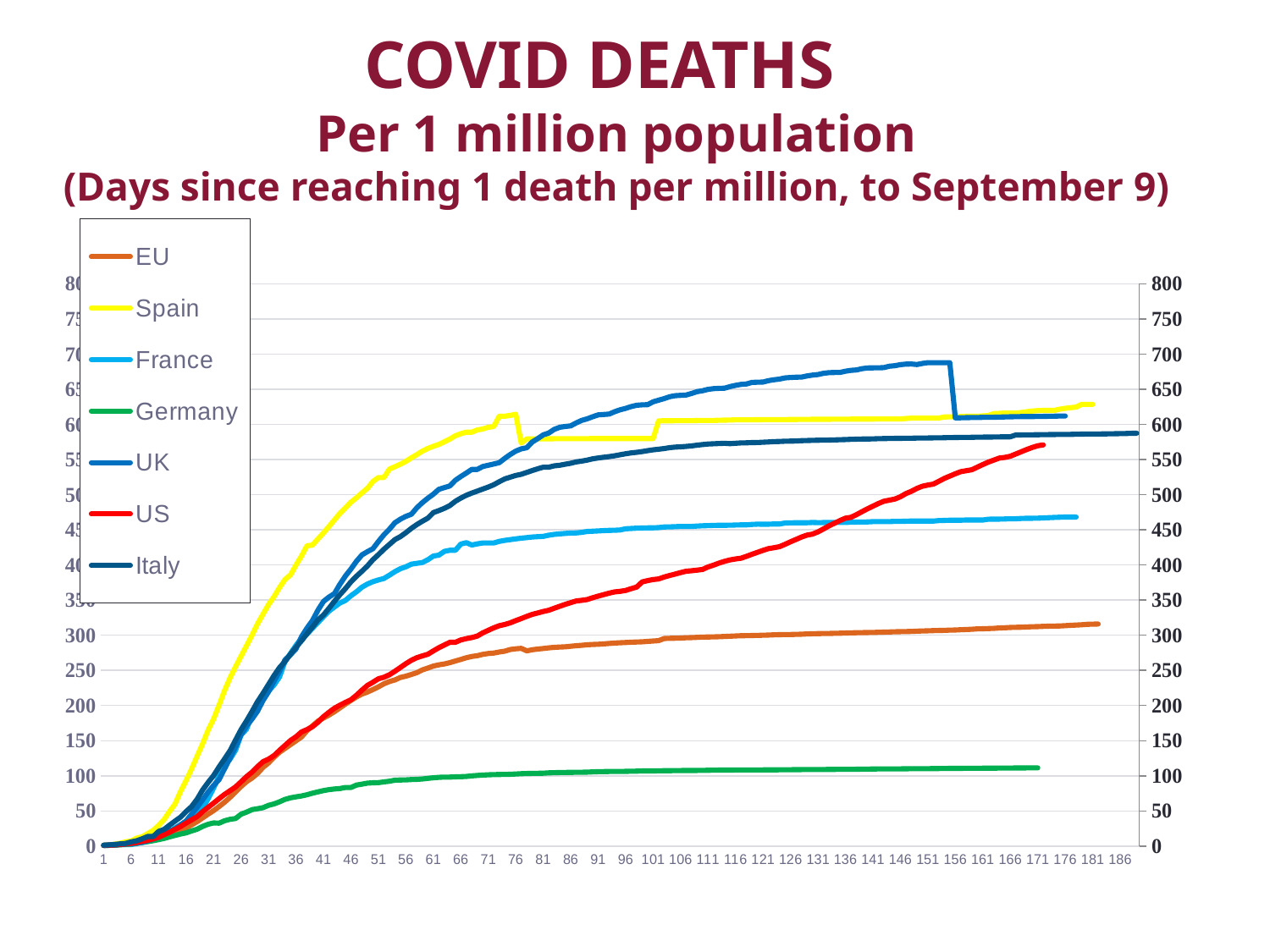
Is the final value for Germany greater or less than 150? less Is the final value for France greater or less than 500? less Which series reaches the highest value at any point on the chart? UK What kind of chart is shown on the slide? line chart What colour is the line for the US? red Does the US line rise or fall as the days increase? rise Is the final value for Spain greater or less than 600? greater At the end of the chart, which is higher, the EU line or the Germany line? EU Which series has the lowest values at the end of the chart? Germany How many series does the legend list? 7